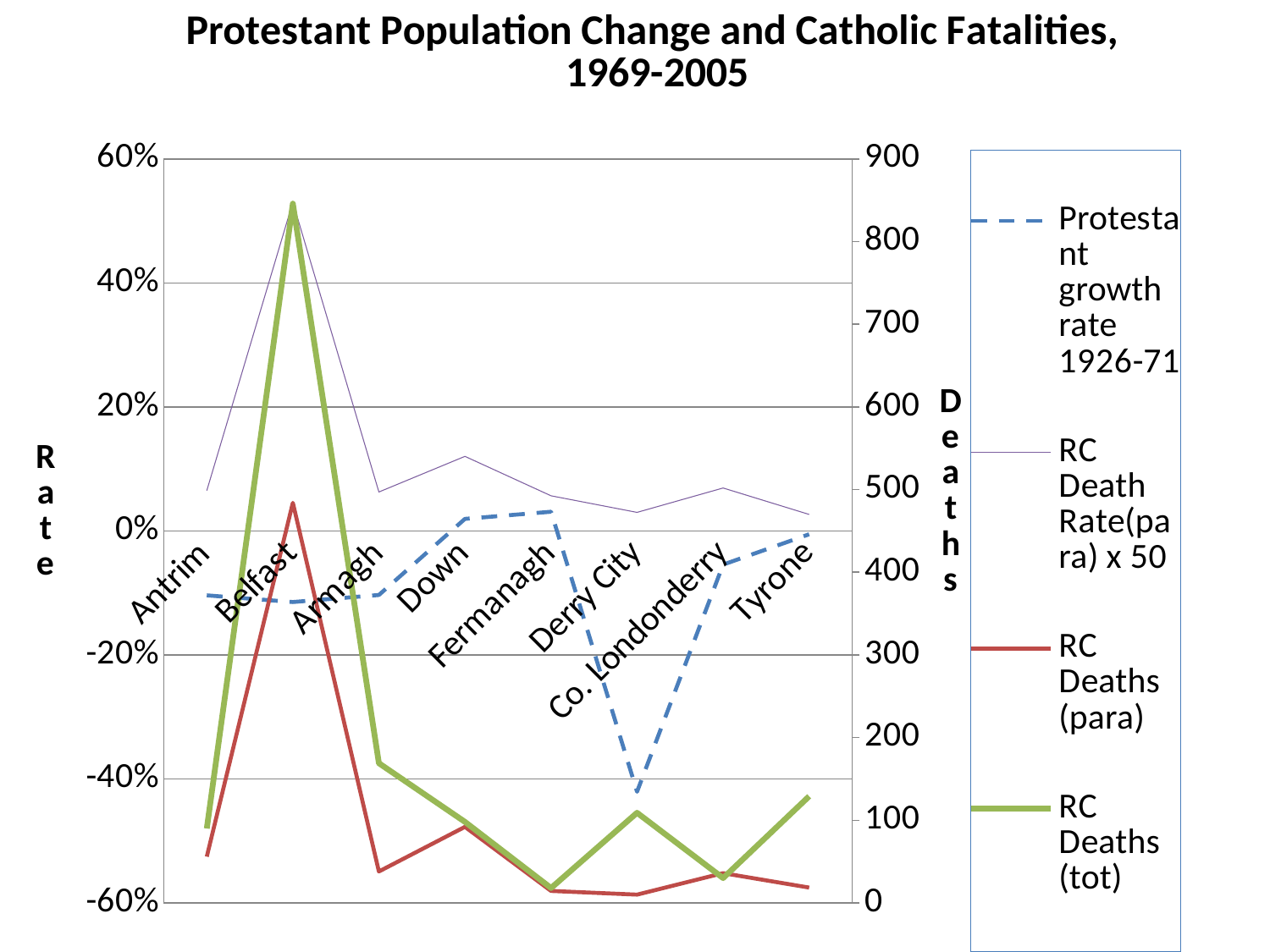
Does the RC Deaths (tot) series rise or fall from Belfast to Fermanagh? fall Is the RC Deaths (tot) value for Antrim greater or less than 200? less Which has the larger RC Deaths (tot) value, Belfast or Armagh? Belfast What is the title of the chart? Protestant Population Change and Catholic Fatalities, 1969-2005 For which category is the Protestant growth rate 1926-71 series lowest? Derry City Which has the larger Protestant growth rate 1926-71 value, Fermanagh or Derry City? Fermanagh What kind of chart is shown on the slide? line chart Is the Protestant growth rate 1926-71 value for Derry City greater or less than -20%? less How many series does the legend list? 4 How many categories are shown along the x axis? 8 For which category is the RC Deaths (tot) series highest? Belfast Is the RC Deaths (tot) value for Belfast greater or less than 700? greater